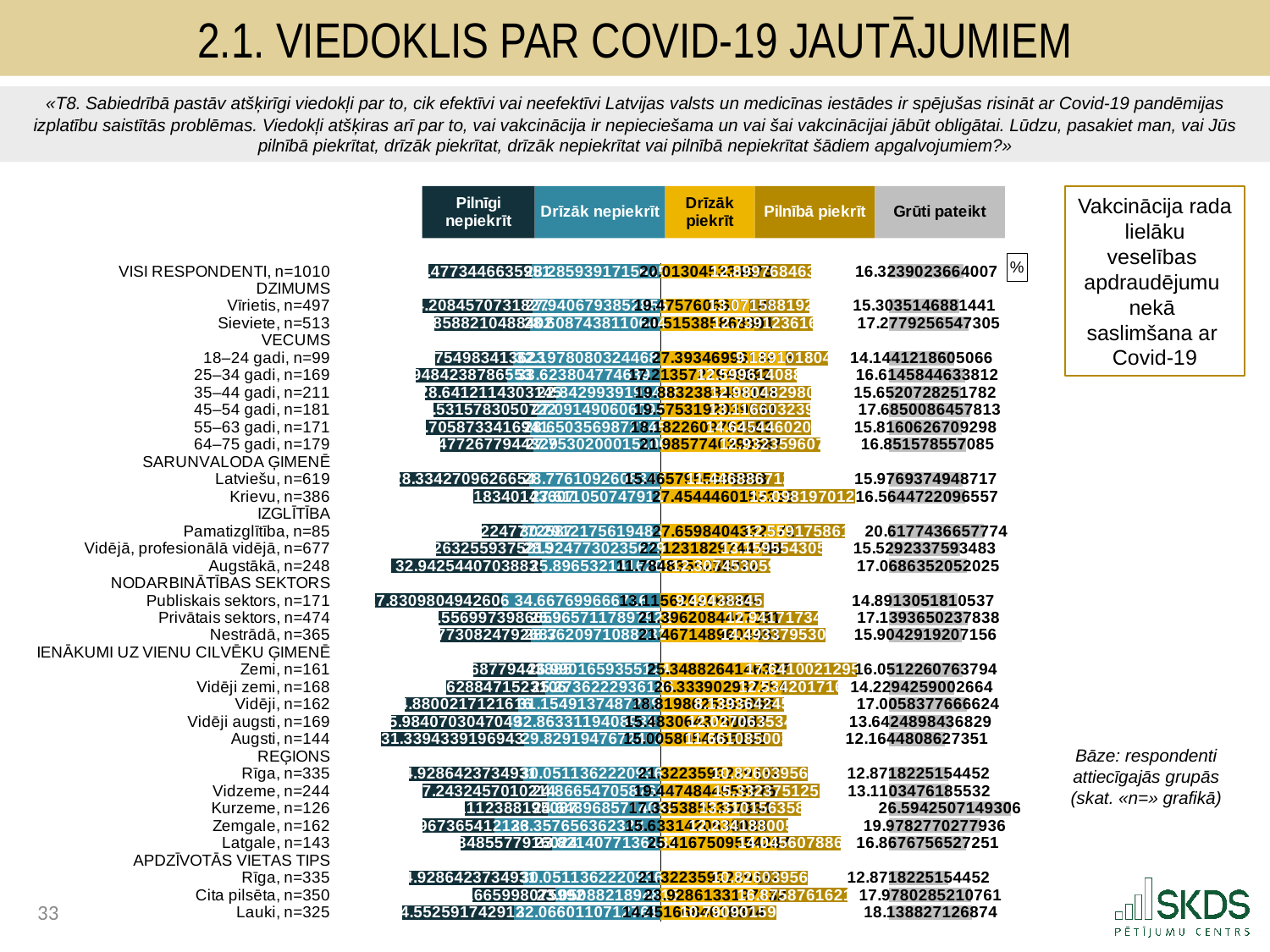
How many response categories does the legend list? 5 Which group has the highest 'Grūti pateikt' value? Kurzeme, n=126 What is the 'Grūti pateikt' value for Augsti, n=144? 12.1644808627351 What is the 'Grūti pateikt' value for VISI RESPONDENTI, n=1010? 16.3239023664007 What is the 'Grūti pateikt' value for Zemgale, n=162? 19.9782770277936 Which legend entry is shown in grey? Grūti pateikt What statement is shown in the box to the right of the chart? Vakcinācija rada lielāku veselības apdraudējumu nekā saslimšana ar Covid-19 Which has a larger 'Grūti pateikt' value, Vīrietis or Sieviete? Sieviete What is the 'Grūti pateikt' value for Kurzeme, n=126? 26.5942507149306 Which group has the lowest 'Grūti pateikt' value? Augsti, n=144 Which has a larger 'Grūti pateikt' value, Kurzeme or Zemgale? Kurzeme What kind of chart is shown on the slide? Stacked bar chart